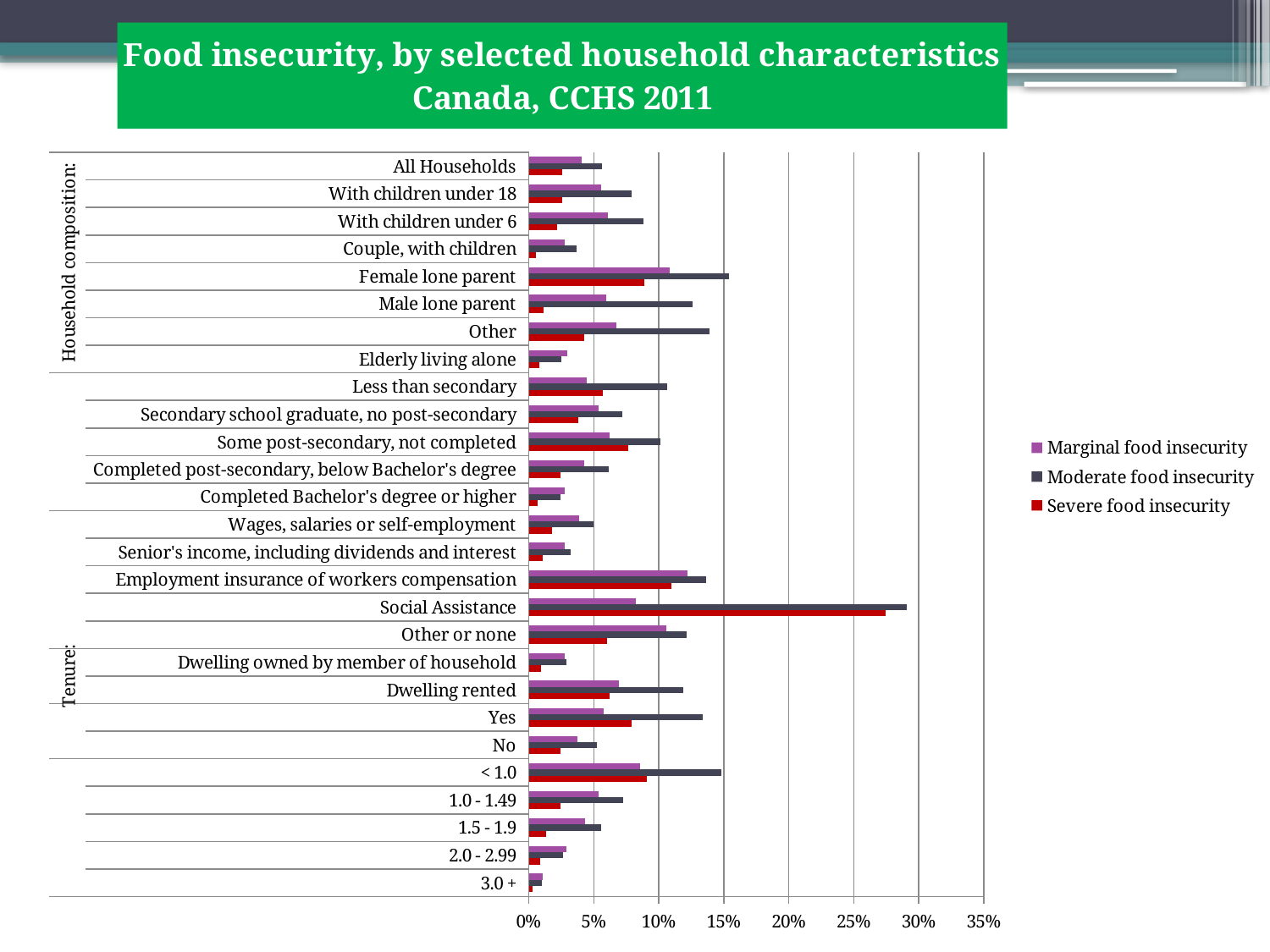
How many household categories are plotted on the chart? 27 What is the title of the chart? Food insecurity, by selected household characteristics Canada, CCHS 2011 Is the Moderate food insecurity value for Social Assistance greater or less than 25%? greater How many series does the legend list? 3 Is the Moderate food insecurity value for Elderly living alone greater or less than 5%? less Which category has the highest Severe food insecurity value? Social Assistance Which is larger: the Severe food insecurity value for Social Assistance or for Employment insurance of workers compensation? Social Assistance Which category has the lowest Moderate food insecurity value? 3.0 + Is the Moderate food insecurity value for Dwelling rented greater or less than 10%? greater Which category has the highest Moderate food insecurity value? Social Assistance What kind of chart is shown on the slide? Bar chart Which is larger: the Marginal food insecurity value for Female lone parent or for Couple, with children? Female lone parent